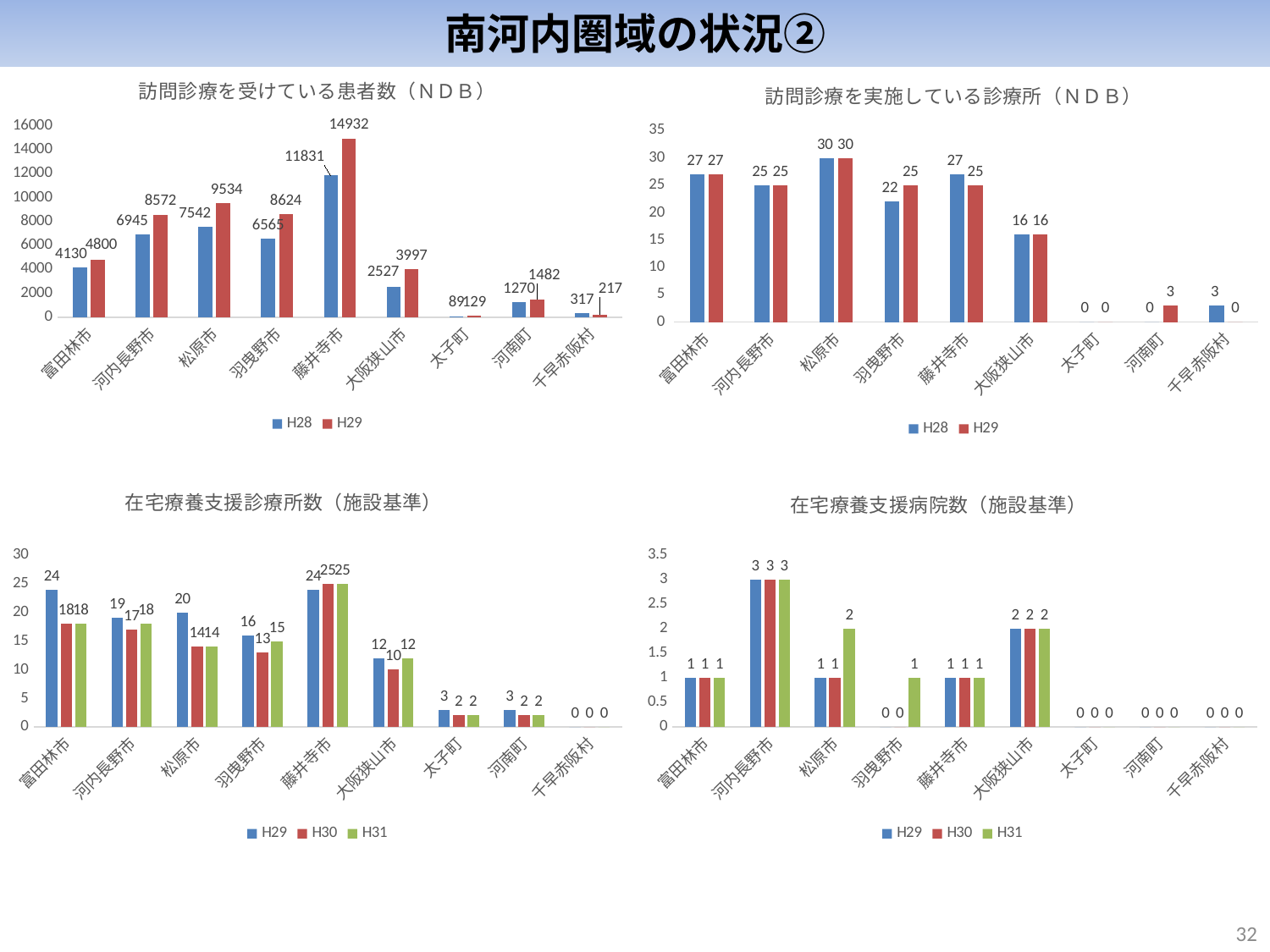
In the chart titled 訪問診療を実施している診療所（ＮＤＢ）, how many series does the legend list? 2 In the chart titled 在宅療養支援診療所数（施設基準）, how many categories are shown on the x axis? 9 What kind of chart is the one titled 在宅療養支援病院数（施設基準）? bar chart In the chart titled 訪問診療を受けている患者数（ＮＤＢ）, which category has the highest H28 value? 藤井寺市 In the chart titled 訪問診療を受けている患者数（ＮＤＢ）, what is the H29 value for 藤井寺市? 14932 In the chart titled 在宅療養支援診療所数（施設基準）, what is the H30 value for 松原市? 14 In the chart titled 訪問診療を受けている患者数（ＮＤＢ）, what is the difference between the H29 and H28 values for 松原市? 1992 In the chart titled 訪問診療を受けている患者数（ＮＤＢ）, which is larger for 千早赤阪村, the H28 value or the H29 value? H28 In the chart titled 在宅療養支援診療所数（施設基準）, do the values for 富田林市 rise or fall from H29 to H31? fall In the chart titled 在宅療養支援病院数（施設基準）, what is the H31 value for 松原市? 2 In the chart titled 訪問診療を実施している診療所（ＮＤＢ）, what is the H29 value for 羽曳野市? 25 In the chart titled 訪問診療を実施している診療所（ＮＤＢ）, which category has the highest H28 value? 松原市